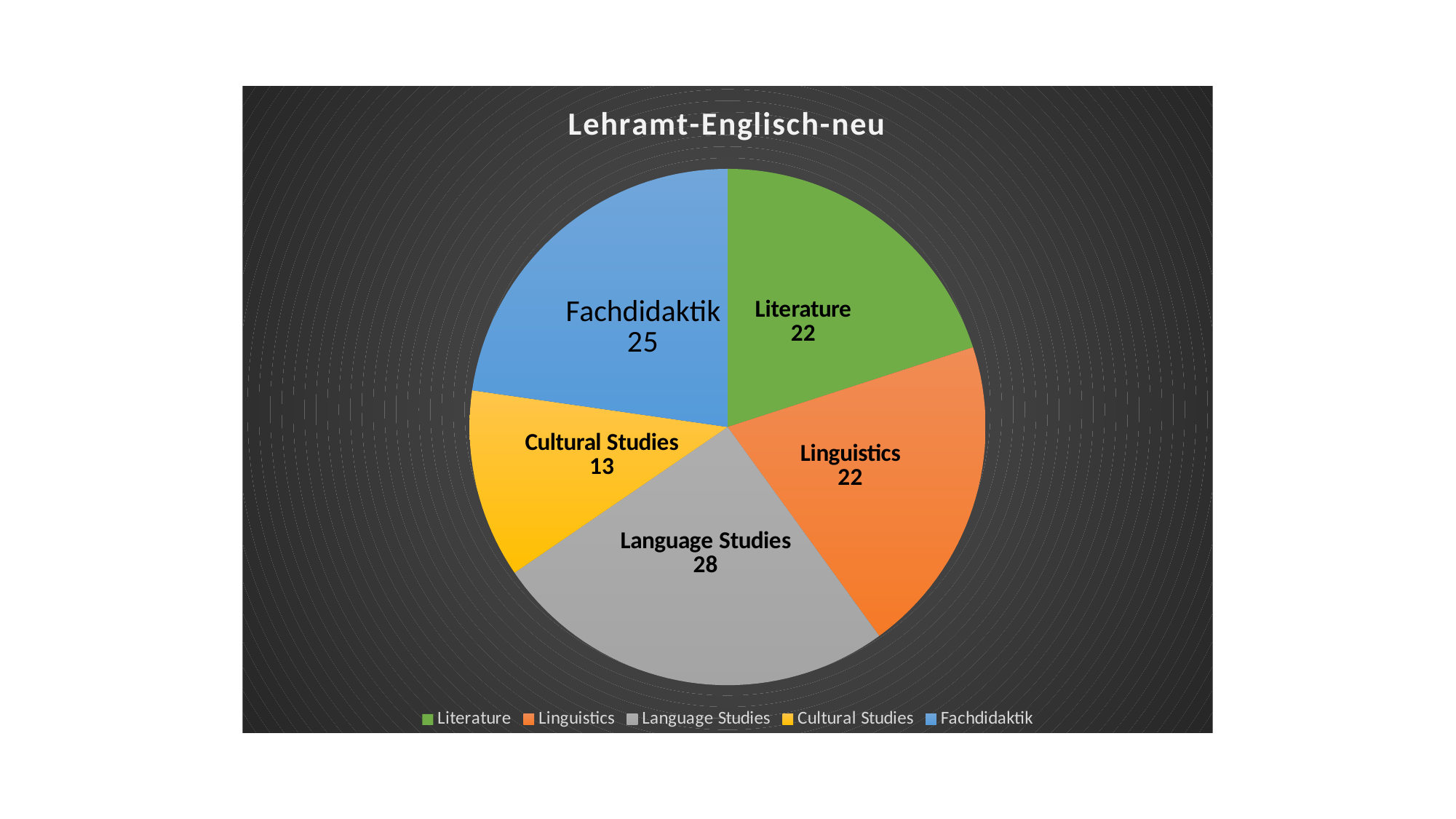
What is the difference between the values for Fachdidaktik and Literature? 3 What is the value for Language Studies? 28 What share of the total does the Literature slice represent? 20% Which category has the smallest slice of the pie? Cultural Studies What is the value for Cultural Studies? 13 What is the difference between the values for Language Studies and Cultural Studies? 15 Which is larger, the value for Fachdidaktik or the value for Linguistics? Fachdidaktik How many categories does the pie chart show? 5 What is the title of the chart? Lehramt-Englisch-neu Which category has the largest slice of the pie? Language Studies What kind of chart is shown on the slide? Pie chart What is the value for Fachdidaktik? 25